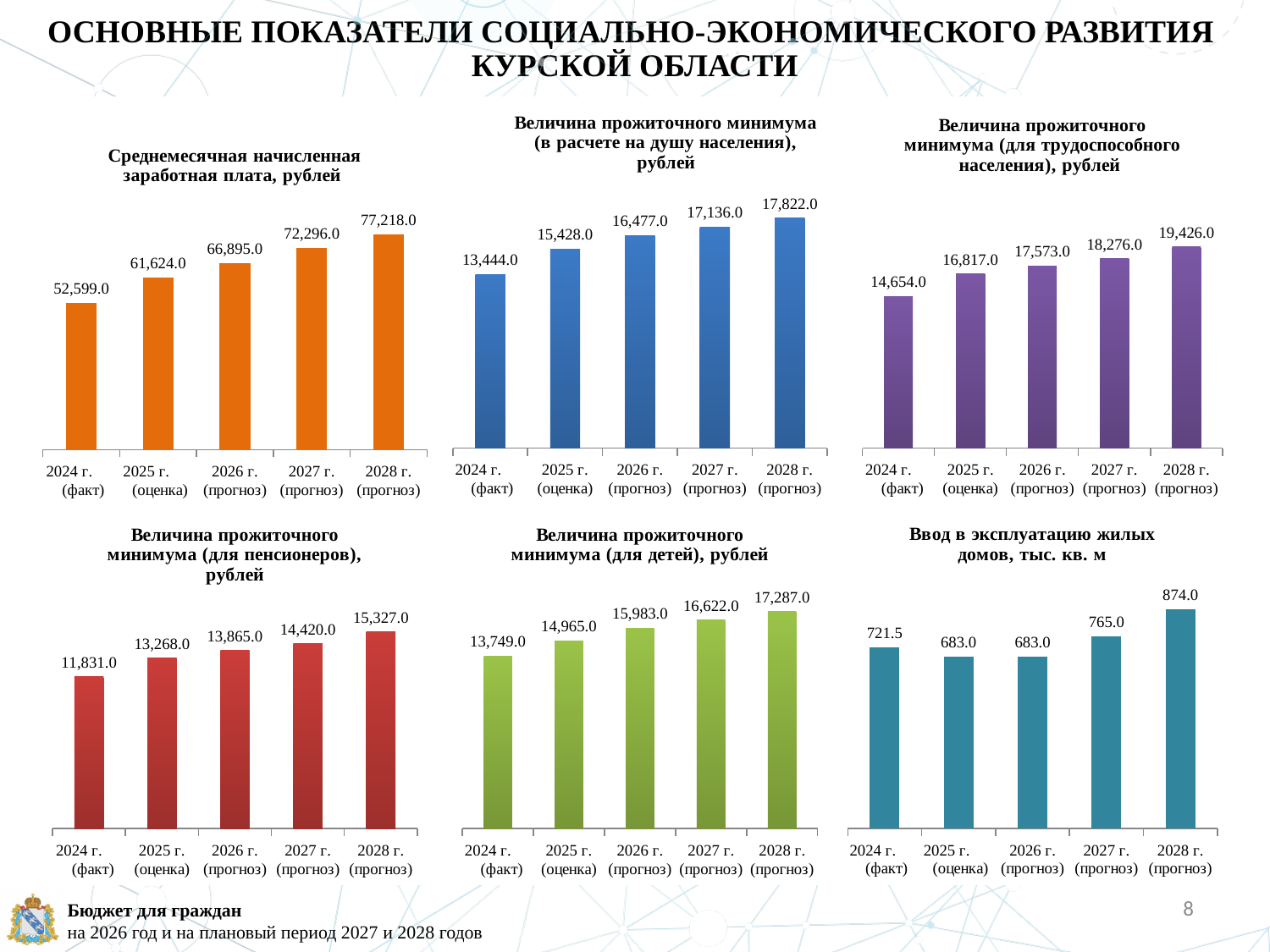
На диаграмме «Величина прожиточного минимума (в расчете на душу населения), рублей» как меняются значения от 2024 г. к 2028 г.? растут На диаграмме «Среднемесячная начисленная заработная плата, рублей» какое значение указано для 2024 г. (факт)? 52,599.0 На диаграмме «Среднемесячная начисленная заработная плата, рублей» какой год имеет наибольшее значение? 2028 г. (прогноз) На диаграмме «Ввод в эксплуатацию жилых домов, тыс. кв. м» какое значение больше: 2024 г. (факт) или 2025 г. (оценка)? 2024 г. (факт) Сколько категорий (лет) показано на диаграмме «Ввод в эксплуатацию жилых домов, тыс. кв. м»? 5 На диаграмме «Ввод в эксплуатацию жилых домов, тыс. кв. м» на сколько значение 2028 г. (прогноз) больше значения 2024 г. (факт)? 152.5 На диаграмме «Среднемесячная начисленная заработная плата, рублей» на сколько значение 2028 г. (прогноз) больше значения 2024 г. (факт)? 24,619.0 На диаграмме «Величина прожиточного минимума (для пенсионеров), рублей» какой год имеет наименьшее значение? 2024 г. (факт) На диаграмме «Величина прожиточного минимума (в расчете на душу населения), рублей» какое значение указано для 2026 г. (прогноз)? 16,477.0 На диаграмме «Величина прожиточного минимума (для детей), рублей» какое значение указано для 2027 г. (прогноз)? 16,622.0 На диаграмме «Величина прожиточного минимума (для трудоспособного населения), рублей» на сколько значение 2028 г. (прогноз) больше значения 2024 г. (факт)? 4,772.0 На диаграмме «Величина прожиточного минимума (для трудоспособного населения), рублей» какое значение указано для 2028 г. (прогноз)? 19,426.0